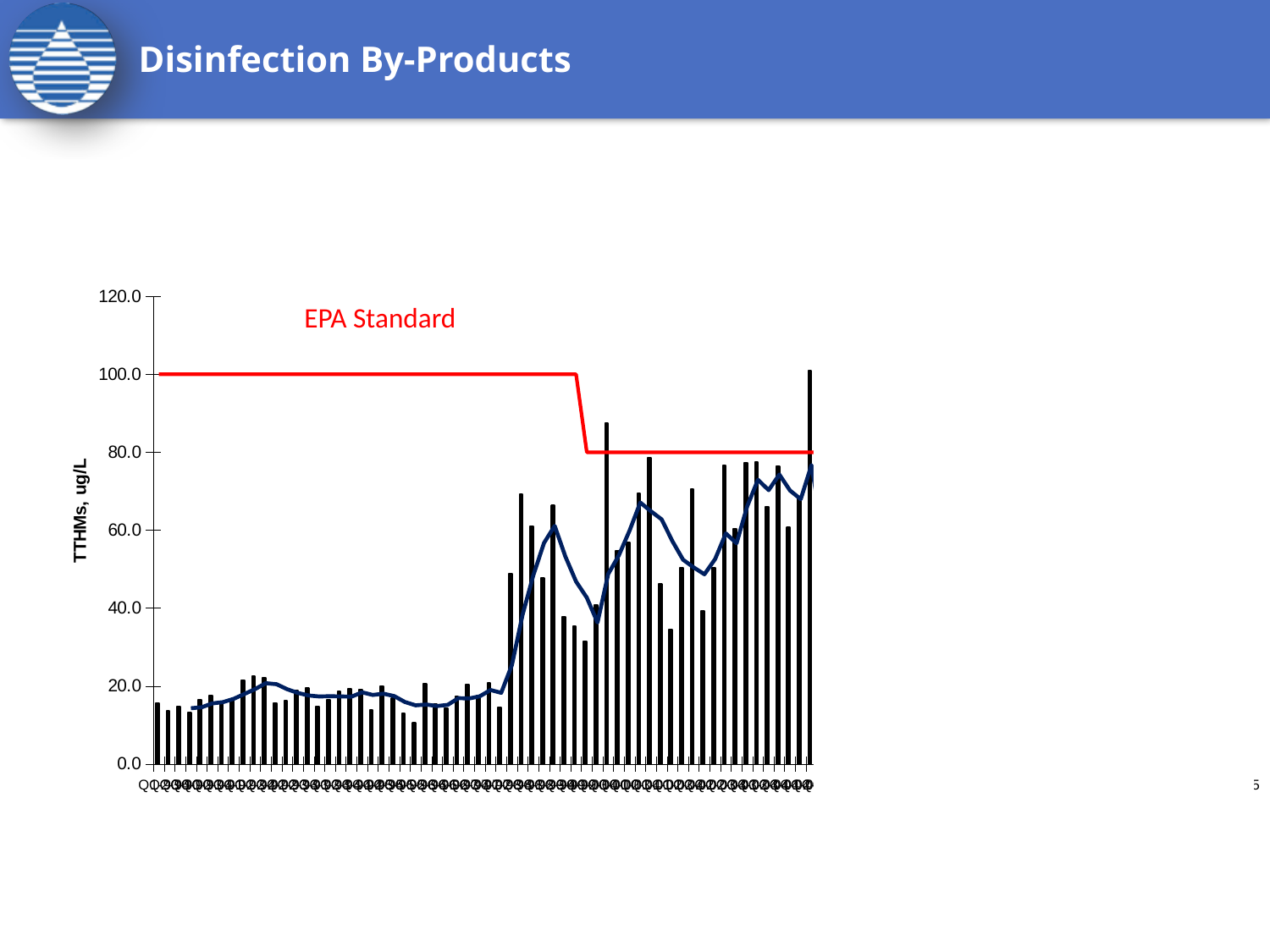
Is the value of the first bar on the left greater or less than 20? less Is the EPA Standard line at the right end of the chart greater or less than 100? less Is the value of the tallest bar greater or less than 80? greater To what value does the EPA Standard line drop on the right side of the chart? 80.0 At what value does the EPA Standard line start on the left side of the chart? 100.0 What is the label on the vertical axis of the chart? TTHMs, ug/L What kind of chart is shown on the slide? combination bar and line chart What is the highest value shown on the vertical axis? 120.0 What text annotation is shown in red on the chart? EPA Standard Do the bar values generally rise or fall from left to right along the x axis? rise